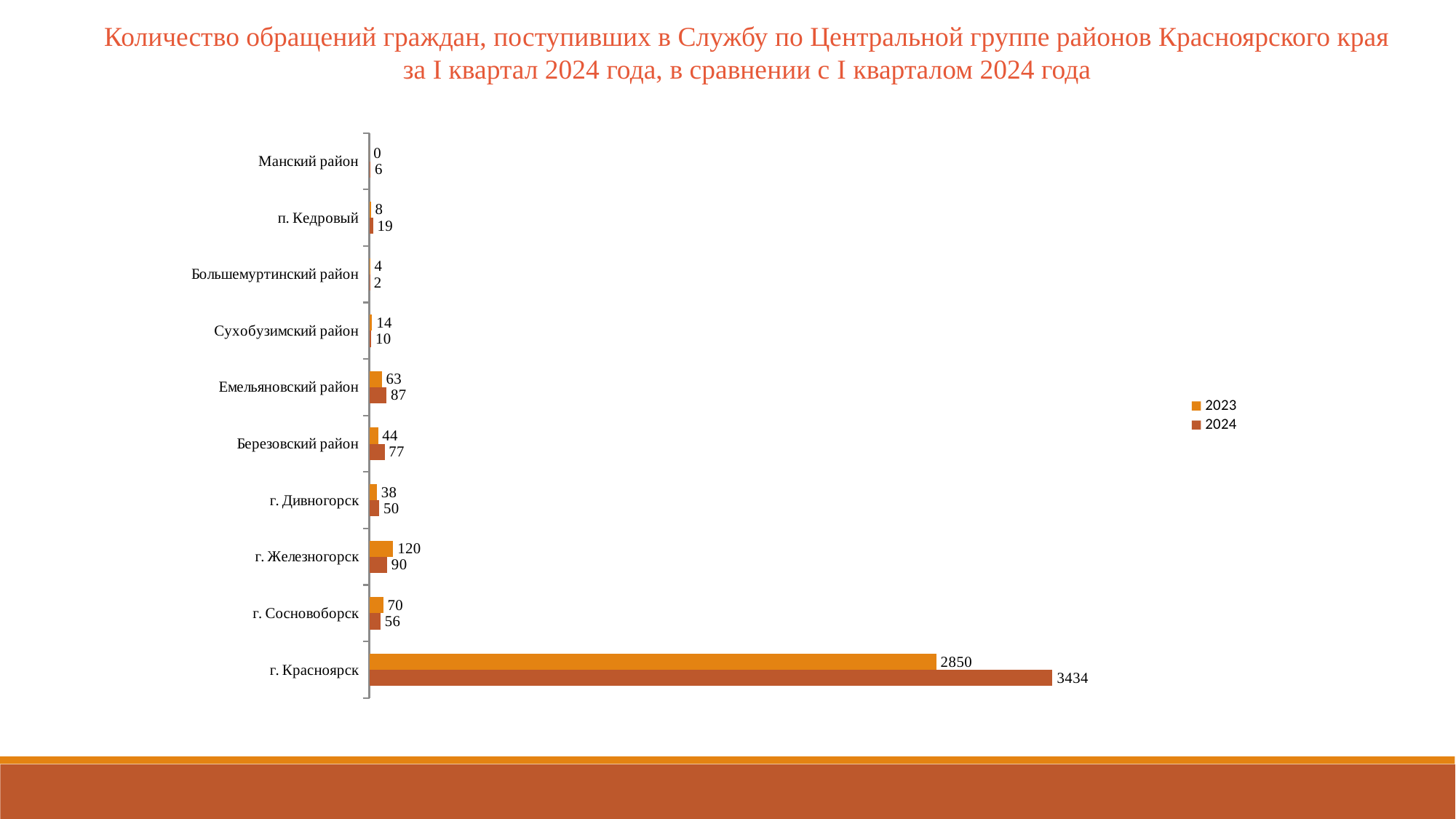
Which is larger for г. Сосновоборск: the 2023 value or the 2024 value? 2023 Which category has the highest value in the 2023 series? г. Красноярск Which is larger for Березовский район: the 2023 value or the 2024 value? 2024 What is the value for г. Железногорск in the 2023 series? 120 What kind of chart is shown on the slide? bar chart How many categories are shown on the chart? 10 What is the difference between the 2024 and 2023 values for г. Красноярск? 584 What is the value for г. Красноярск in the 2024 series? 3434 Which category has the lowest value in the 2023 series? Манский район What is the difference between the 2023 and 2024 values for г. Железногорск? 30 What is the value for Емельяновский район in the 2024 series? 87 How many series does the legend list? 2